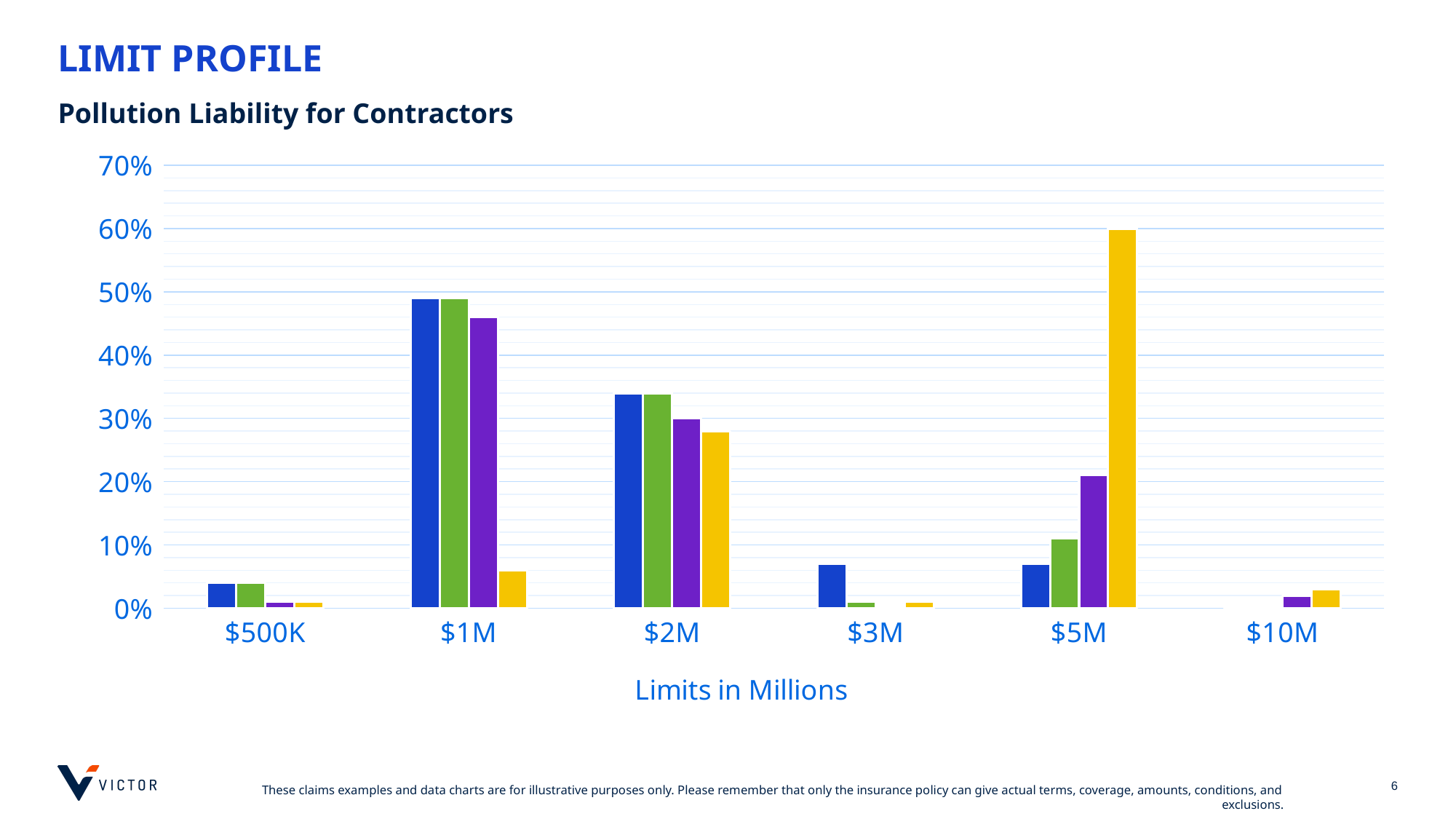
What is the title of the x axis? Limits in Millions Is the yellow bar for $5M greater or less than 50%? greater Which is larger, the yellow bar for $5M or the yellow bar for $1M? $5M Is the blue bar for $1M greater or less than 40%? greater Is the yellow bar for $2M greater or less than 30%? less Which limit category contains the tallest bar on the chart? $5M How many limit categories are shown on the x axis? 6 Which limit category has the tallest blue bar? $1M What kind of chart is shown on the slide? bar chart Which limit category has the tallest yellow bar? $5M Which is larger, the blue bar for $1M or the blue bar for $2M? $1M